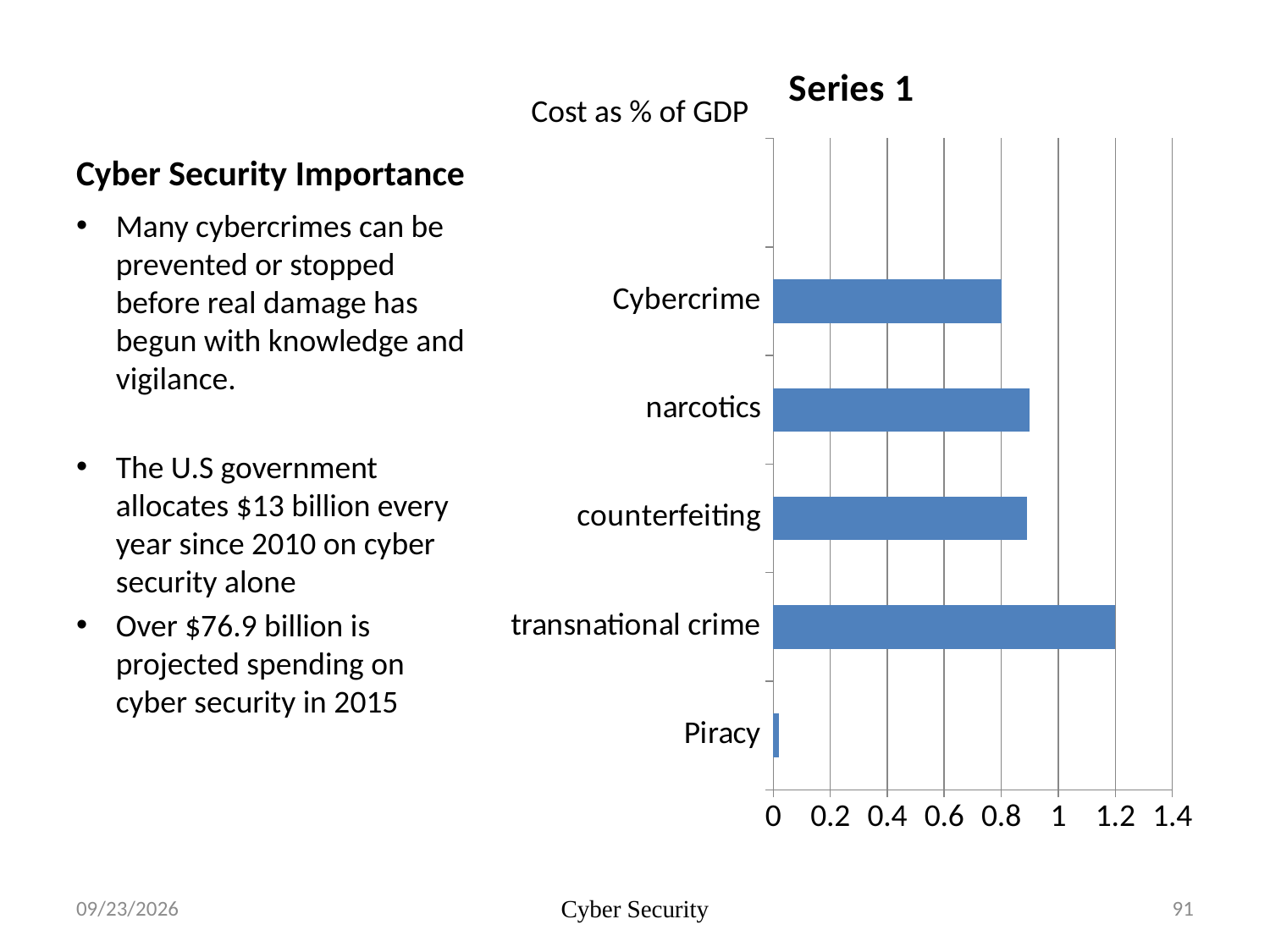
Is the value for narcotics greater or less than 0.8? greater What label appears above the chart describing the measure plotted? Cost as % of GDP Which category has the lowest value in the chart? Piracy How many categories are plotted in the chart? 5 Is the value for counterfeiting greater or less than 1? less Which category has the highest value in the chart? transnational crime What kind of chart is shown on the slide? bar chart What is the value for transnational crime? 1.2 What is the value for Cybercrime? 0.8 What is the title of the chart? Series 1 Is the value for Piracy greater or less than 0.2? less Which is larger, the value for transnational crime or the value for Cybercrime? transnational crime